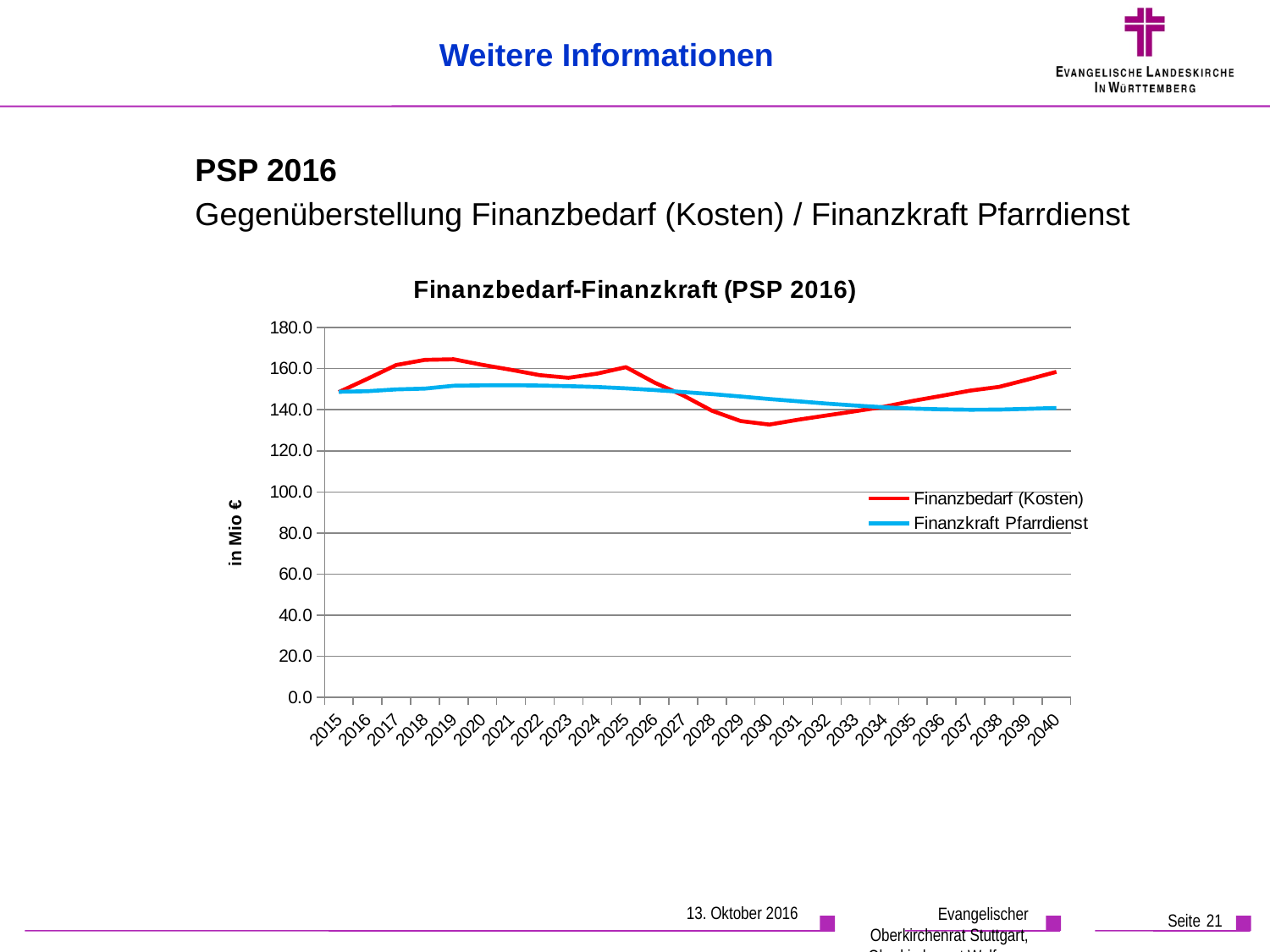
What is the label of the y axis? in Mio € In which year is Finanzbedarf (Kosten) at its lowest? 2030 Is the value for Finanzbedarf (Kosten) in 2019 greater or less than 160? greater How many years are plotted along the x axis? 26 In 2019, which series has the higher value, Finanzbedarf (Kosten) or Finanzkraft Pfarrdienst? Finanzbedarf (Kosten) How many series does the legend list? 2 What kind of chart is shown on the slide? line chart Is the value for Finanzkraft Pfarrdienst in 2021 greater or less than 140? greater Is the value for Finanzbedarf (Kosten) in 2040 greater or less than 140? greater What is the title of the chart? Finanzbedarf-Finanzkraft (PSP 2016) In 2030, which series has the higher value, Finanzbedarf (Kosten) or Finanzkraft Pfarrdienst? Finanzkraft Pfarrdienst